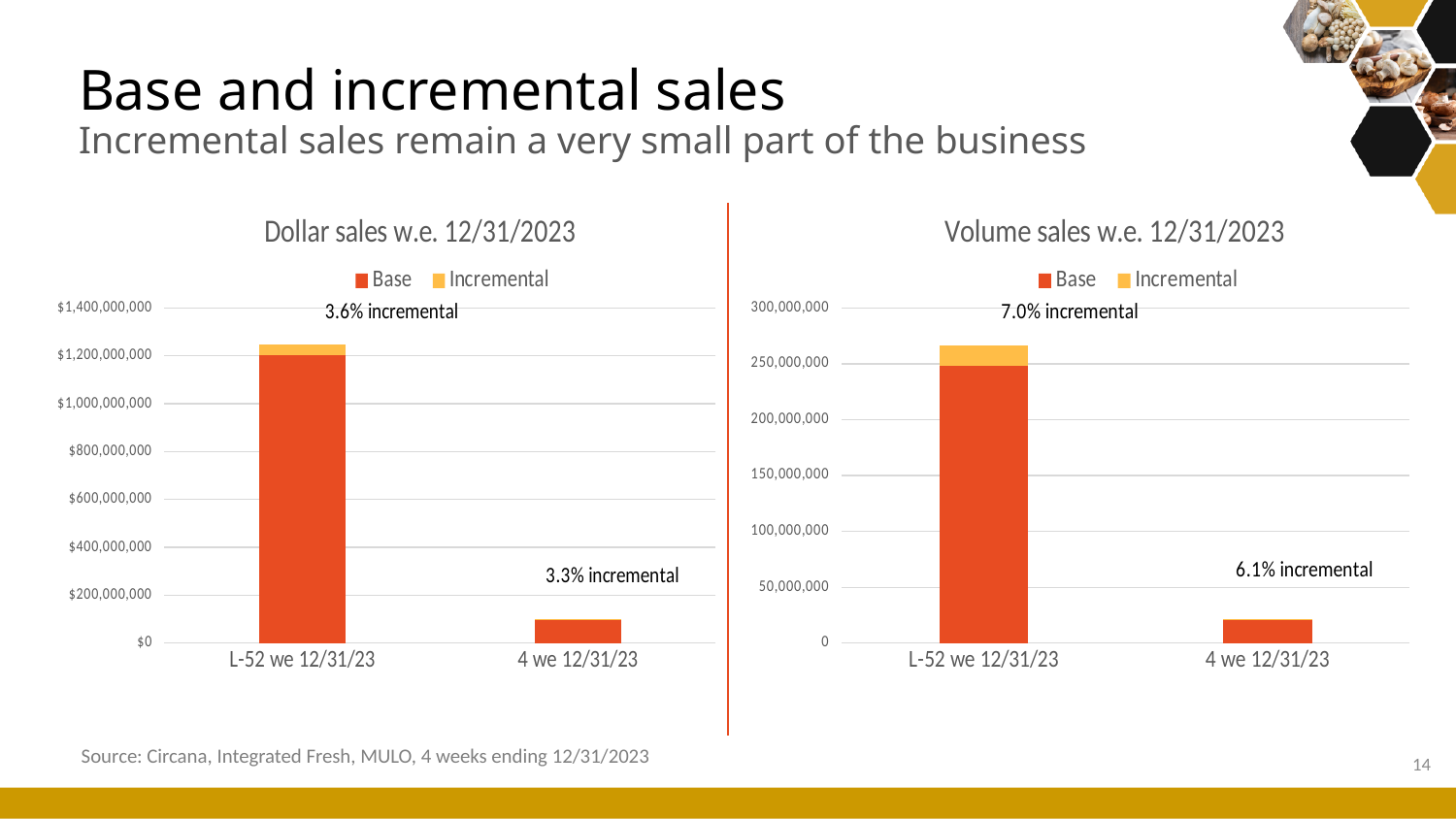
In the Dollar sales w.e. 12/31/2023 chart, what percentage of sales is labeled as incremental for L-52 we 12/31/23? 3.6% incremental In the Dollar sales w.e. 12/31/2023 chart, is the total stacked bar for 4 we 12/31/23 greater or less than $200,000,000? less In the Dollar sales w.e. 12/31/2023 chart, what percentage of sales is labeled as incremental for 4 we 12/31/23? 3.3% incremental In the Volume sales w.e. 12/31/2023 chart, is the total stacked bar for 4 we 12/31/23 greater or less than 50,000,000? less In the Volume sales w.e. 12/31/2023 chart, what percentage of sales is labeled as incremental for 4 we 12/31/23? 6.1% incremental In the Dollar sales w.e. 12/31/2023 chart, is the total stacked bar for L-52 we 12/31/23 greater or less than $1,000,000,000? greater In the Dollar sales w.e. 12/31/2023 chart, which category has the taller stacked bar? L-52 we 12/31/23 What kind of chart is the Dollar sales w.e. 12/31/2023 chart? Stacked bar chart In the Volume sales w.e. 12/31/2023 chart, which category has the shorter stacked bar? 4 we 12/31/23 How many series does the legend of the Volume sales w.e. 12/31/2023 chart list? 2 In the Volume sales w.e. 12/31/2023 chart, what percentage of sales is labeled as incremental for L-52 we 12/31/23? 7.0% incremental